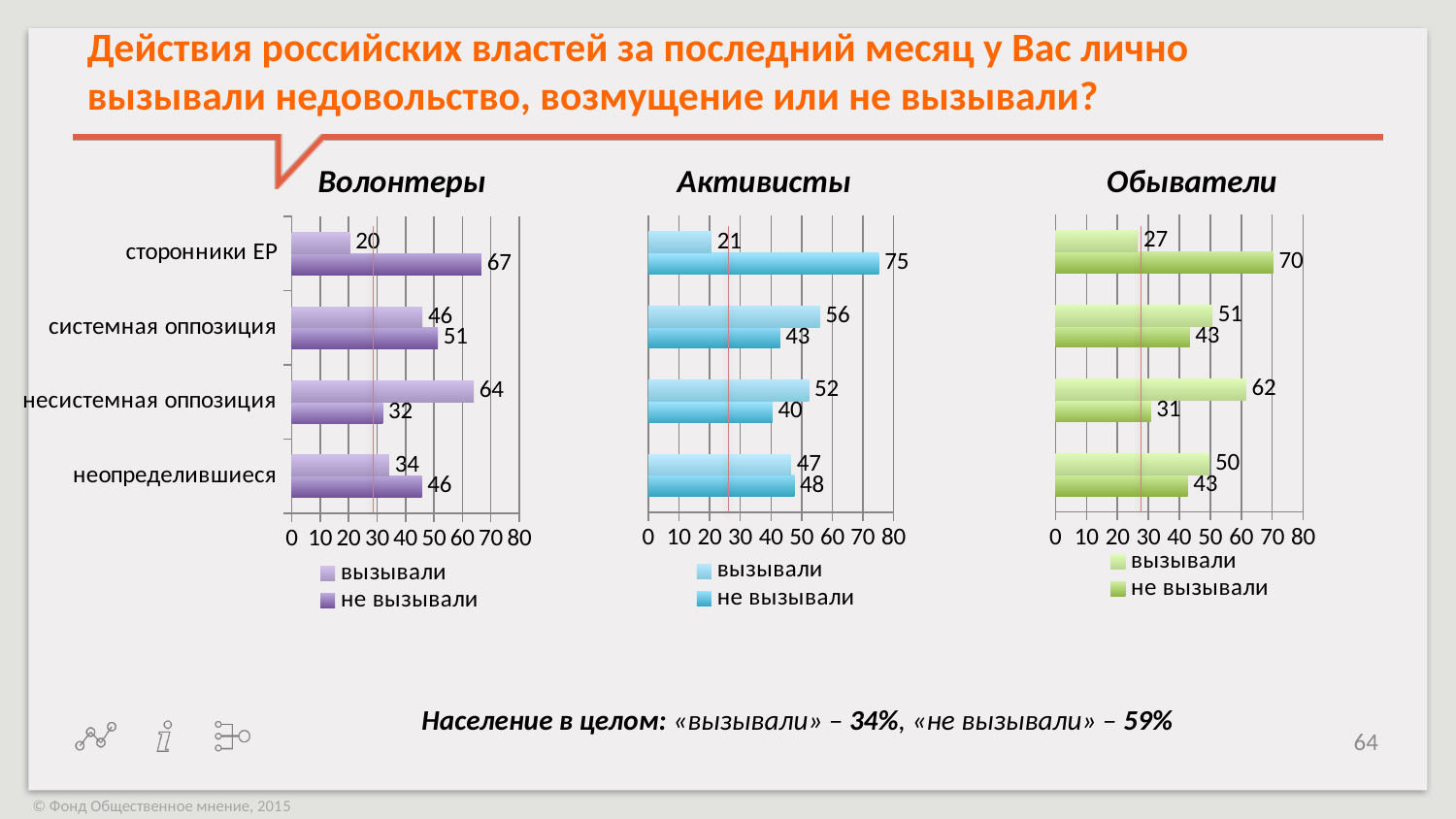
In the Волонтеры chart, what is the value of «вызывали» for сторонники ЕР? 20 In the Волонтеры chart, which is larger for системная оппозиция: «вызывали» or «не вызывали»? не вызывали In the Активисты chart, which category has the lowest «не вызывали» value? несистемная оппозиция In the Волонтеры chart, which category has the highest «вызывали» value? несистемная оппозиция In the Обыватели chart, what is the value of «вызывали» for несистемная оппозиция? 62 In the Обыватели chart, what is the difference between «вызывали» and «не вызывали» for несистемная оппозиция? 31 How many series does the legend of the Волонтеры chart list? 2 In the Активисты chart, what is the value of «не вызывали» for сторонники ЕР? 75 In the Обыватели chart, what is the difference between «не вызывали» and «вызывали» for сторонники ЕР? 43 What type of chart is the Активисты chart? bar chart How many categories are shown in the Обыватели chart? 4 In the Активисты chart, is the «вызывали» value for системная оппозиция greater or less than 50? greater